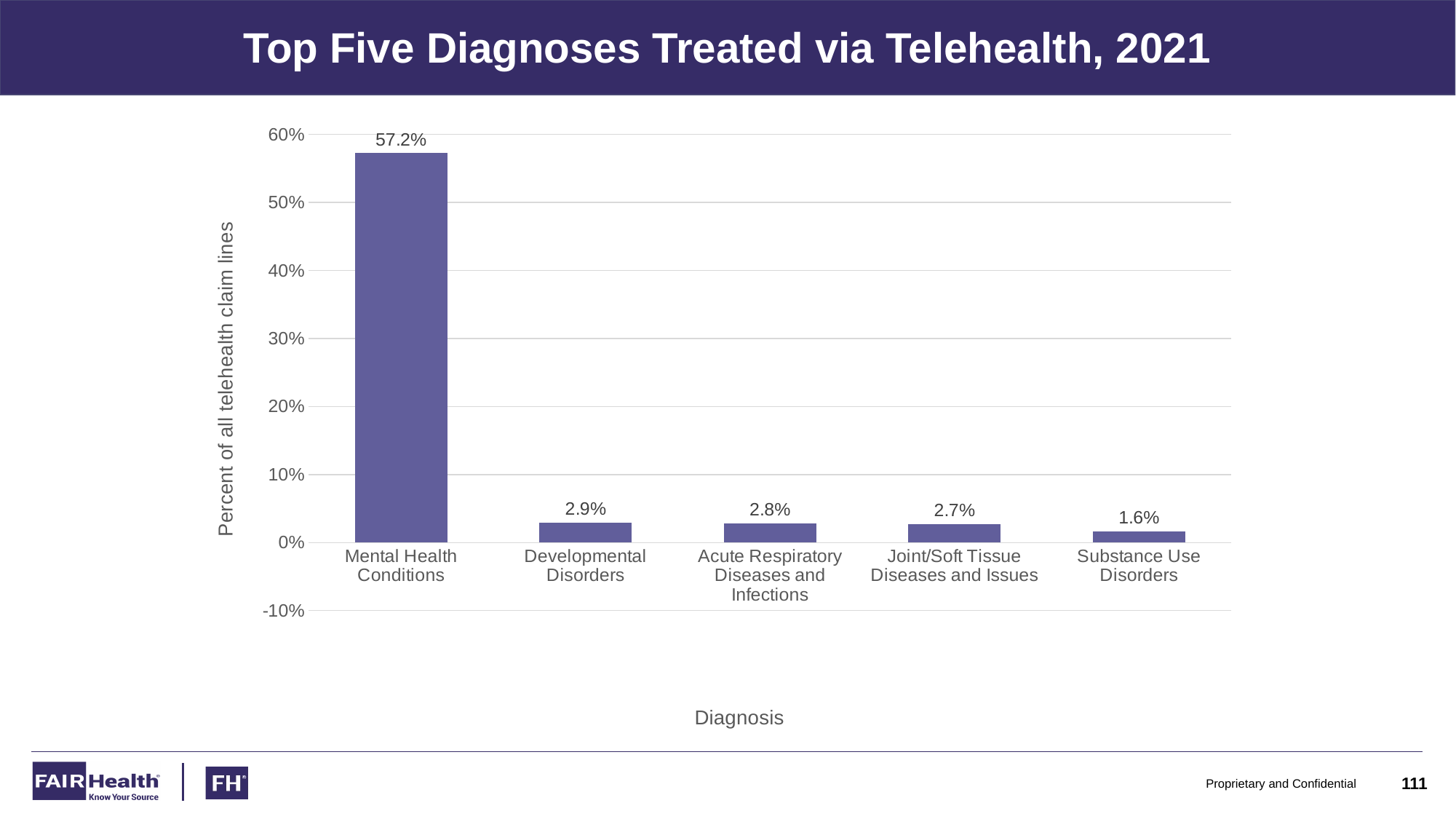
What percent of all telehealth claim lines is shown for Mental Health Conditions? 57.2% Is the value for Mental Health Conditions greater or less than 50%? greater Which is larger, the value for Mental Health Conditions or the value for Acute Respiratory Diseases and Infections? Mental Health Conditions Which diagnosis has the lowest percent of telehealth claim lines? Substance Use Disorders What is the difference between the values for Acute Respiratory Diseases and Infections and Substance Use Disorders? 1.2% What is the value for Joint/Soft Tissue Diseases and Issues? 2.7% What is the value for Substance Use Disorders? 1.6% How many diagnoses are shown on the chart? 5 What is the value for Developmental Disorders? 2.9% Which diagnosis has the highest percent of telehealth claim lines? Mental Health Conditions What is the difference between the values for Mental Health Conditions and Developmental Disorders? 54.3% What kind of chart is shown on the slide? Bar chart